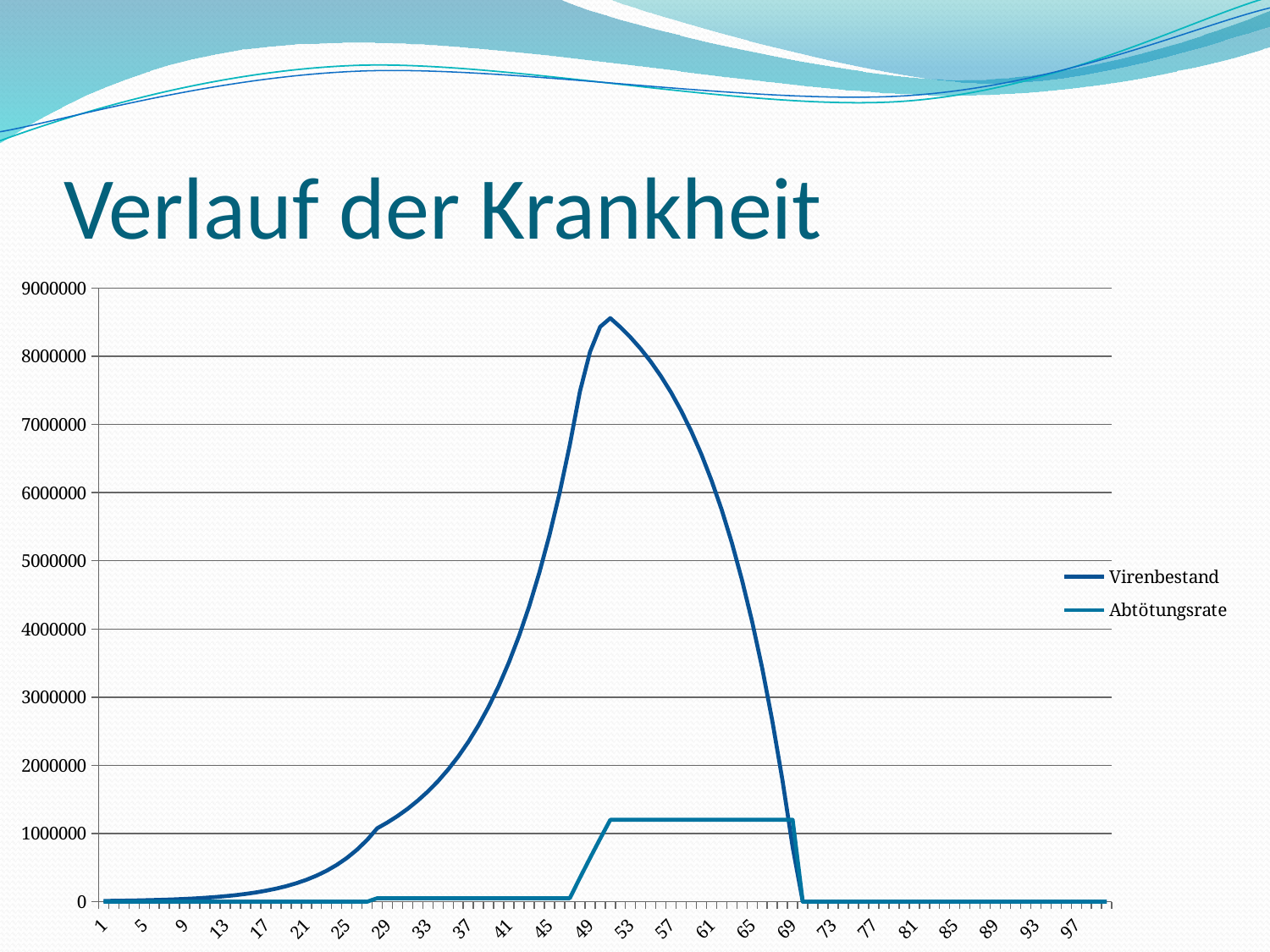
Which series reaches the higher peak value, Virenbestand or Abtötungsrate? Virenbestand At x = 61, which series has the larger value, Virenbestand or Abtötungsrate? Virenbestand Is the value of Abtötungsrate at x = 61 greater or less than 2000000? less What kind of chart is shown on the slide? line chart What are the two series named in the legend? Virenbestand and Abtötungsrate What is the title of the chart? Verlauf der Krankheit How many series does the legend list? 2 Is the value of Virenbestand at x = 25 greater or less than 1000000? less Is the value of Virenbestand at x = 33 greater or less than 1000000? greater Does the Virenbestand line rise or fall between x = 53 and x = 69? fall What is the value of Abtötungsrate at x = 81? 0